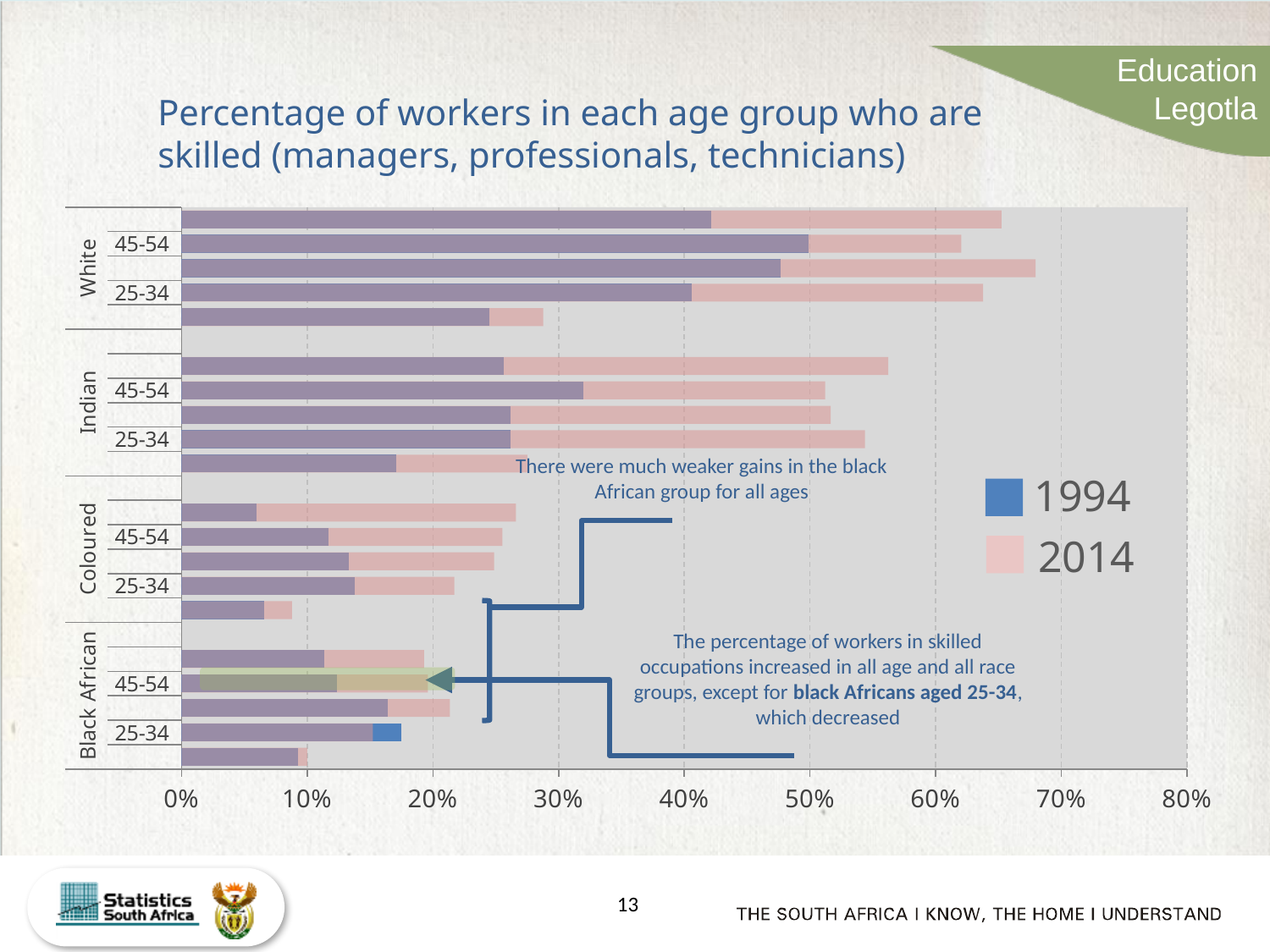
Is the 1994 value for Coloured workers aged 45-54 greater or less than 10%? greater What kind of chart is shown on the slide? bar chart For Black African workers aged 25-34, which year has the larger value, 1994 or 2014? 1994 How many race groups are shown on the vertical axis? 4 Is the 2014 value for Indian workers aged 25-34 greater or less than 50%? greater Is the 1994 value for Indian workers aged 45-54 greater or less than 30%? greater For workers aged 45-54 in 2014, which race group has the highest value? White How many series does the legend list? 2 Which two years are listed in the legend? 1994 and 2014 For workers aged 45-54 in 2014, which race group has the lowest value? Black African